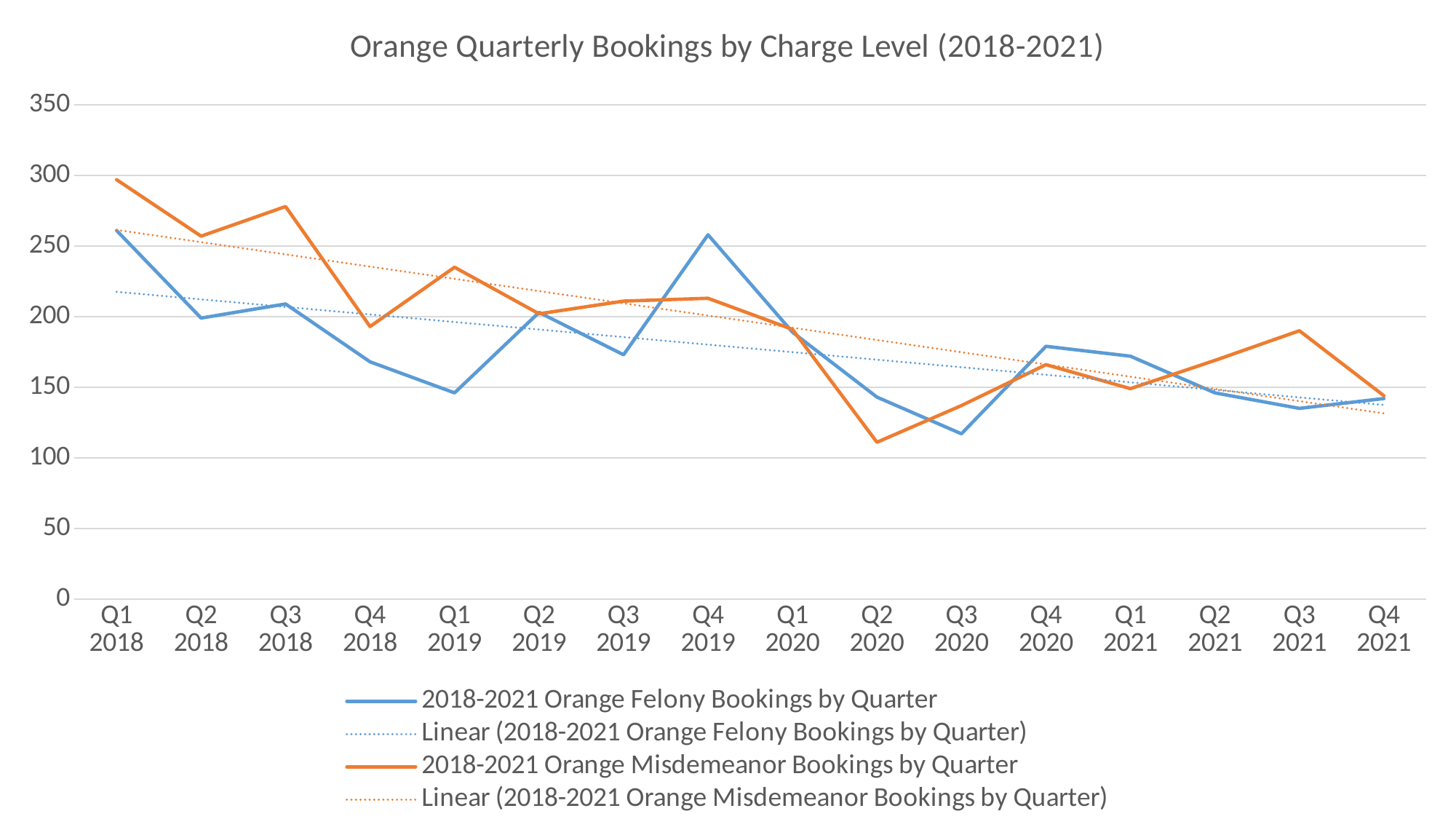
Is the value for felony bookings in Q3 2020 greater or less than 150? less How many entries does the legend list? 4 In which quarter is the felony bookings line at its lowest? Q3 2020 In Q3 2021, which is larger: felony bookings or misdemeanor bookings? Misdemeanor bookings How many quarters are plotted along the x axis? 16 Do the linear trendlines for both series rise or fall from 2018 to 2021? Fall Is the value for misdemeanor bookings in Q1 2018 greater or less than 250? greater In which quarter is the misdemeanor bookings line at its highest? Q1 2018 What kind of chart is shown on the slide? Line chart In which quarter is the misdemeanor bookings line at its lowest? Q2 2020 In Q4 2019, which is larger: felony bookings or misdemeanor bookings? Felony bookings What is the title of the chart? Orange Quarterly Bookings by Charge Level (2018-2021)